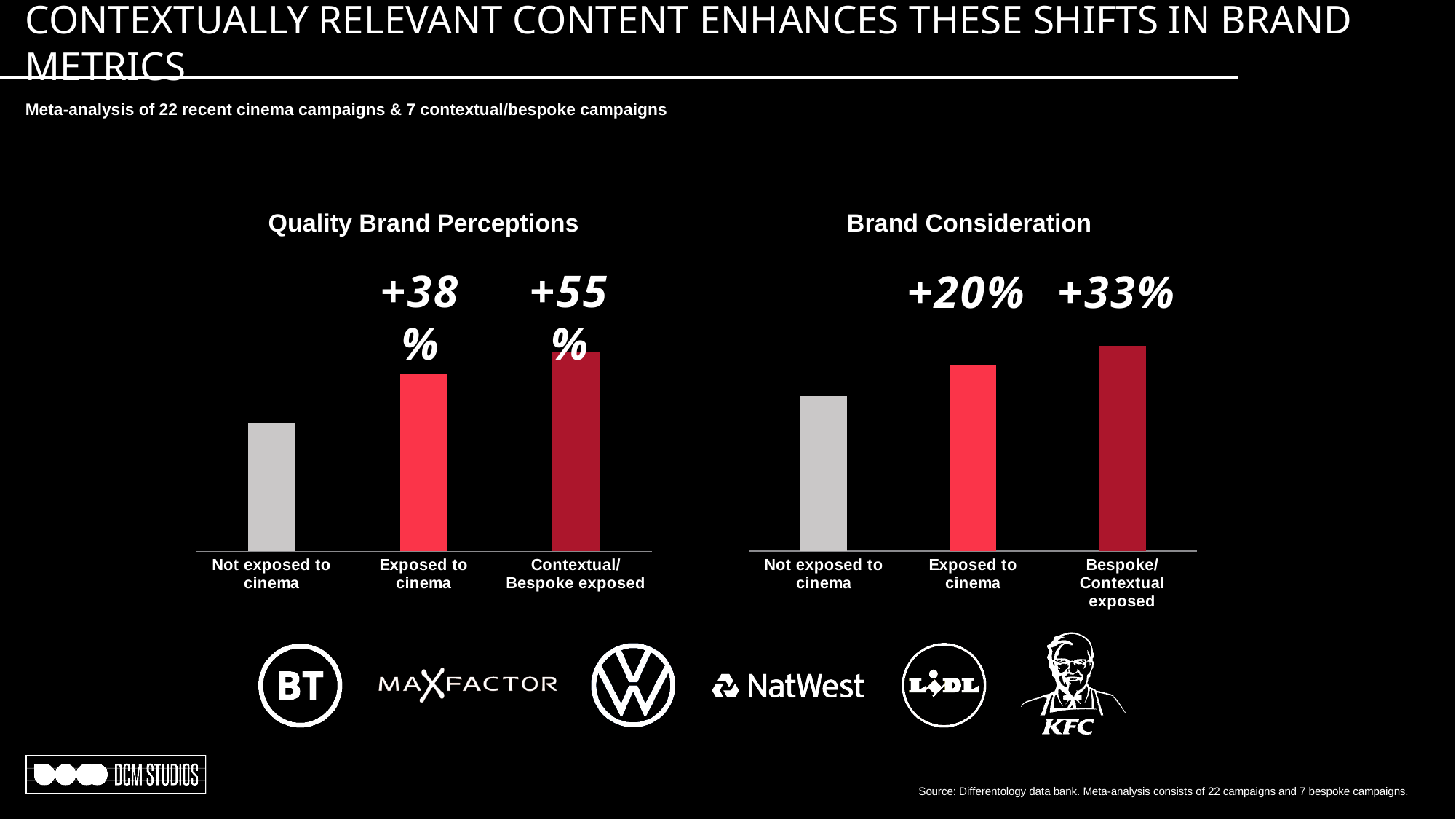
In the Brand Consideration chart, which bar is taller: Exposed to cinema or Not exposed to cinema? Exposed to cinema In the Brand Consideration chart, which category has the tallest bar? Bespoke/Contextual exposed In the Quality Brand Perceptions chart, which category has the shortest bar? Not exposed to cinema How many bars does the Brand Consideration chart have? 3 In the Quality Brand Perceptions chart, which category has the tallest bar? Contextual/Bespoke exposed In the Brand Consideration chart, which category has the shortest bar? Not exposed to cinema In the Brand Consideration chart, what uplift is printed above the Bespoke/Contextual exposed bar? +33% What kind of chart is the Quality Brand Perceptions chart? bar chart In the Quality Brand Perceptions chart, what uplift is printed above the Contextual/Bespoke exposed bar? +55% In the Quality Brand Perceptions chart, what uplift is printed above the Exposed to cinema bar? +38% What is the title of the chart on the right side of the slide? Brand Consideration In the Brand Consideration chart, what uplift is printed above the Exposed to cinema bar? +20%